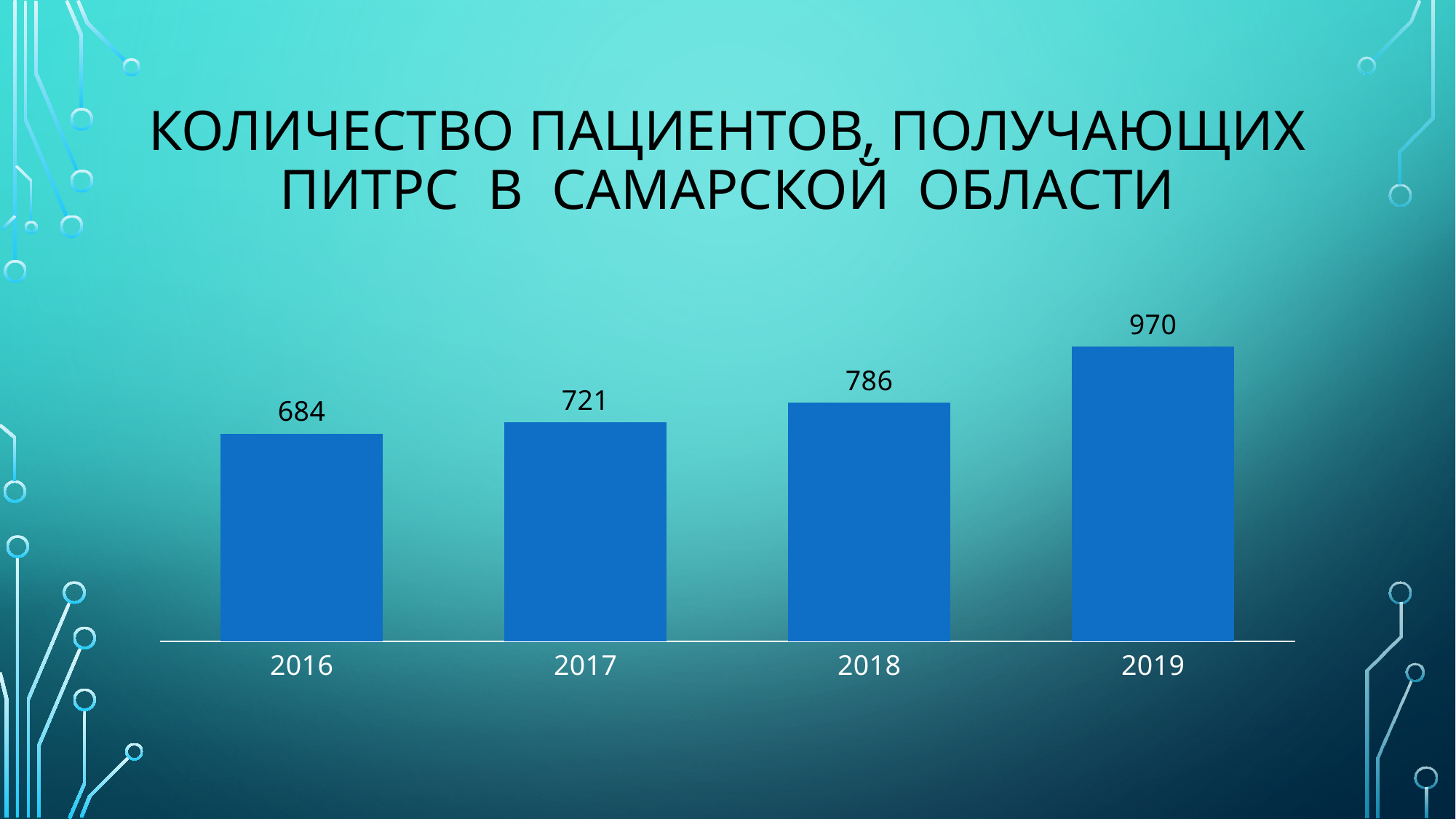
What is the difference between the values for 2019 and 2018? 184 Which is larger, the value for 2018 or the value for 2017? 2018 What kind of chart is shown on the slide? Bar chart Do the values rise or fall from 2016 to 2019? Rise What value is shown for 2017? 721 How many years are shown on the chart? 4 Which year has the highest number of patients? 2019 What value is shown for 2018? 786 Which year has the lowest number of patients? 2016 What value is shown for 2019? 970 What is the difference between the values for 2017 and 2016? 37 What is the number of patients receiving PITRS in the Samara region in 2016? 684